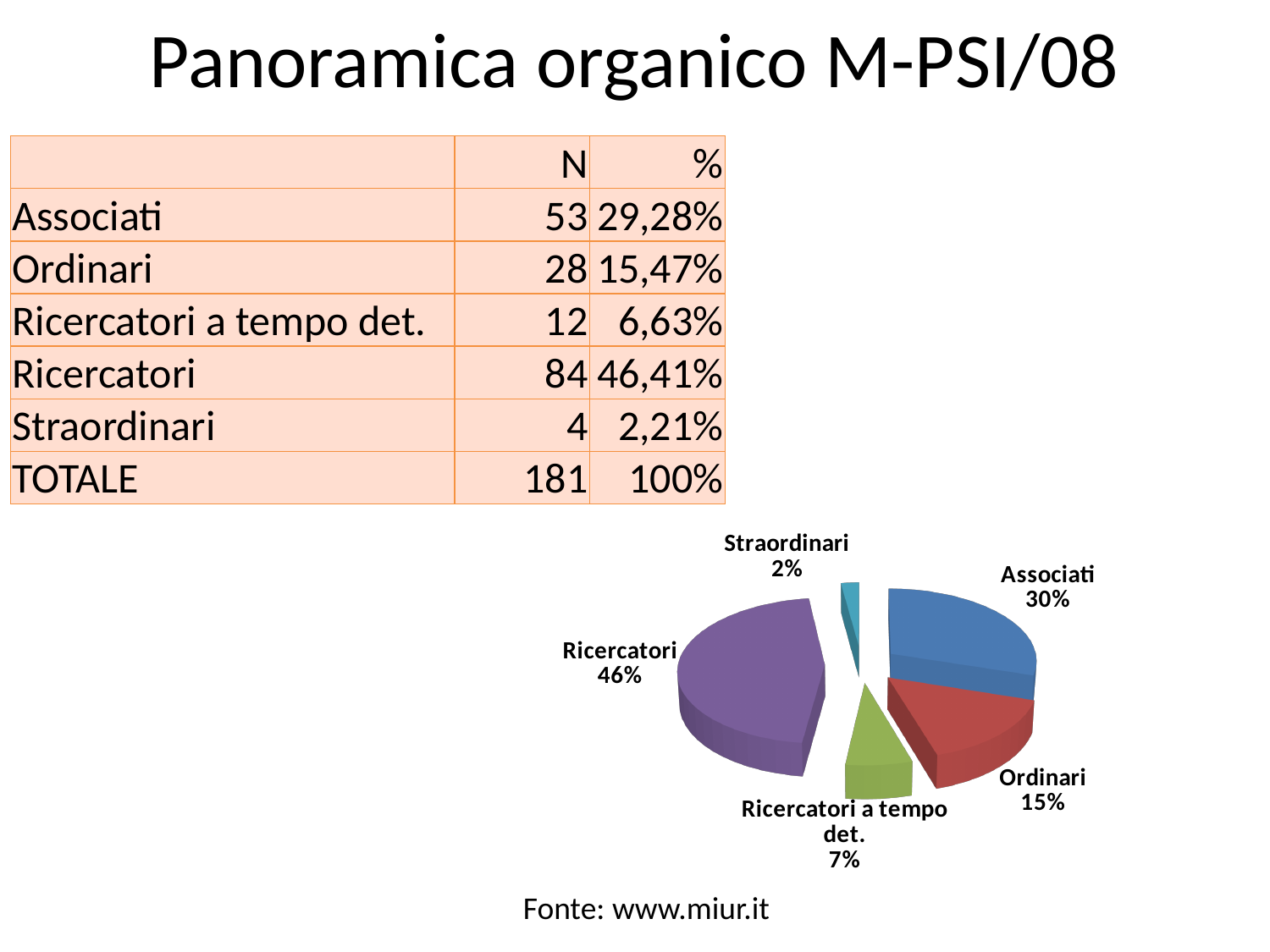
In the pie chart, what is the difference in percentage points between the Ricercatori slice and the Associati slice? 16 What colour is the Ricercatori slice in the pie chart? purple What share of the pie chart does Ordinari represent? 15% Which category has the smallest slice in the pie chart? Straordinari What share of the pie chart does Straordinari represent? 2% What share of the pie chart does Ricercatori represent? 46% How many slices does the pie chart have? 5 What kind of chart is shown on the slide? pie chart Which category has the largest slice in the pie chart? Ricercatori In the pie chart, which slice is larger: Associati or Ordinari? Associati